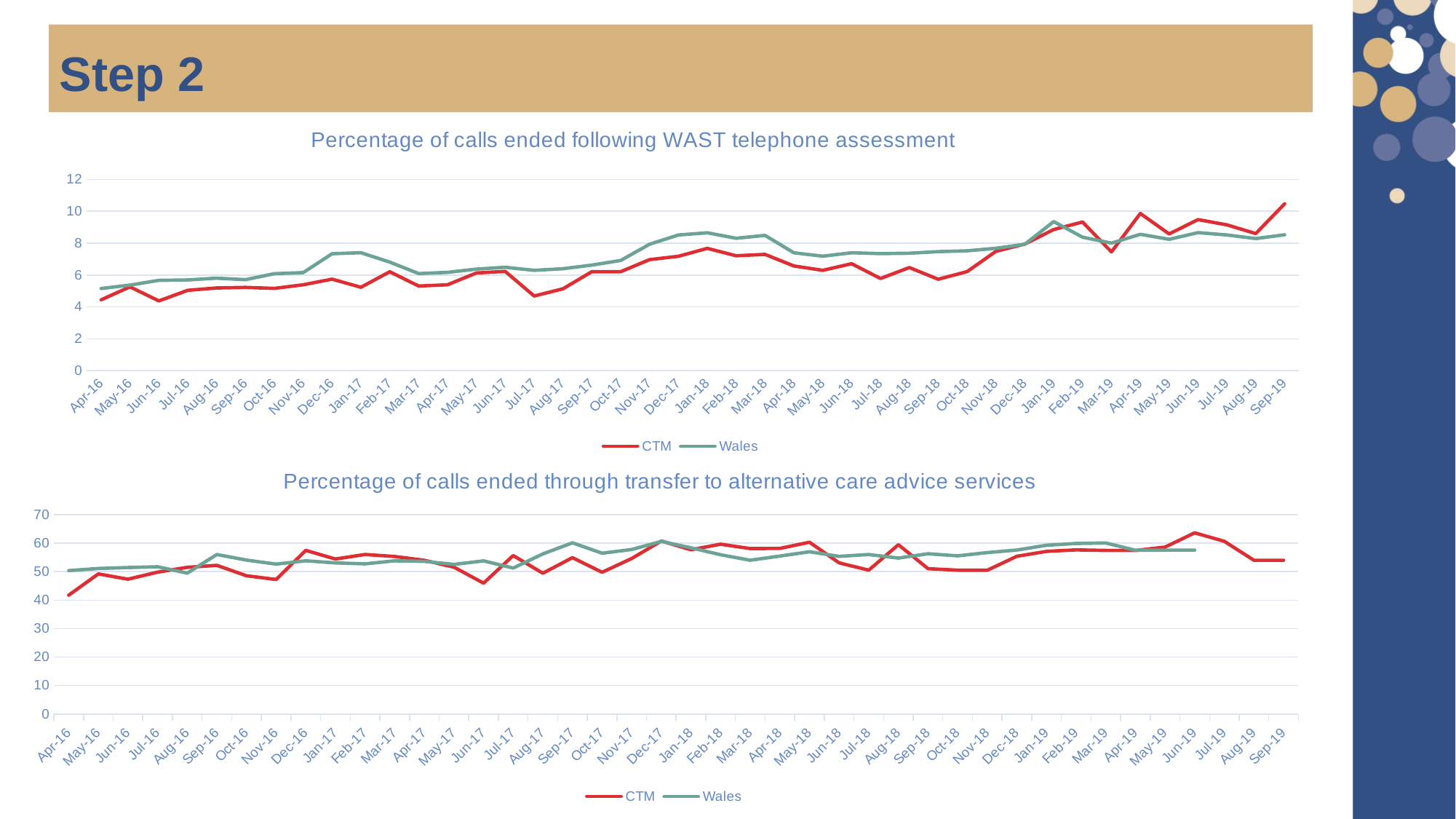
In the bottom chart, is the Wales value for Mar-18 greater or less than 60? less What is the title of the top chart? Percentage of calls ended following WAST telephone assessment Which two series are shown in the legend of the bottom chart? CTM and Wales In the top chart, is the CTM value for Sep-19 greater or less than 10? greater In the top chart, is the CTM value for Apr-16 greater or less than 6? less What kind of chart is the bottom chart, 'Percentage of calls ended through transfer to alternative care advice services'? line chart What kind of chart is the top chart, 'Percentage of calls ended following WAST telephone assessment'? line chart In the top chart, does the CTM line generally rise or fall from Apr-16 to Sep-19? rise How many series does the legend of the top chart list? 2